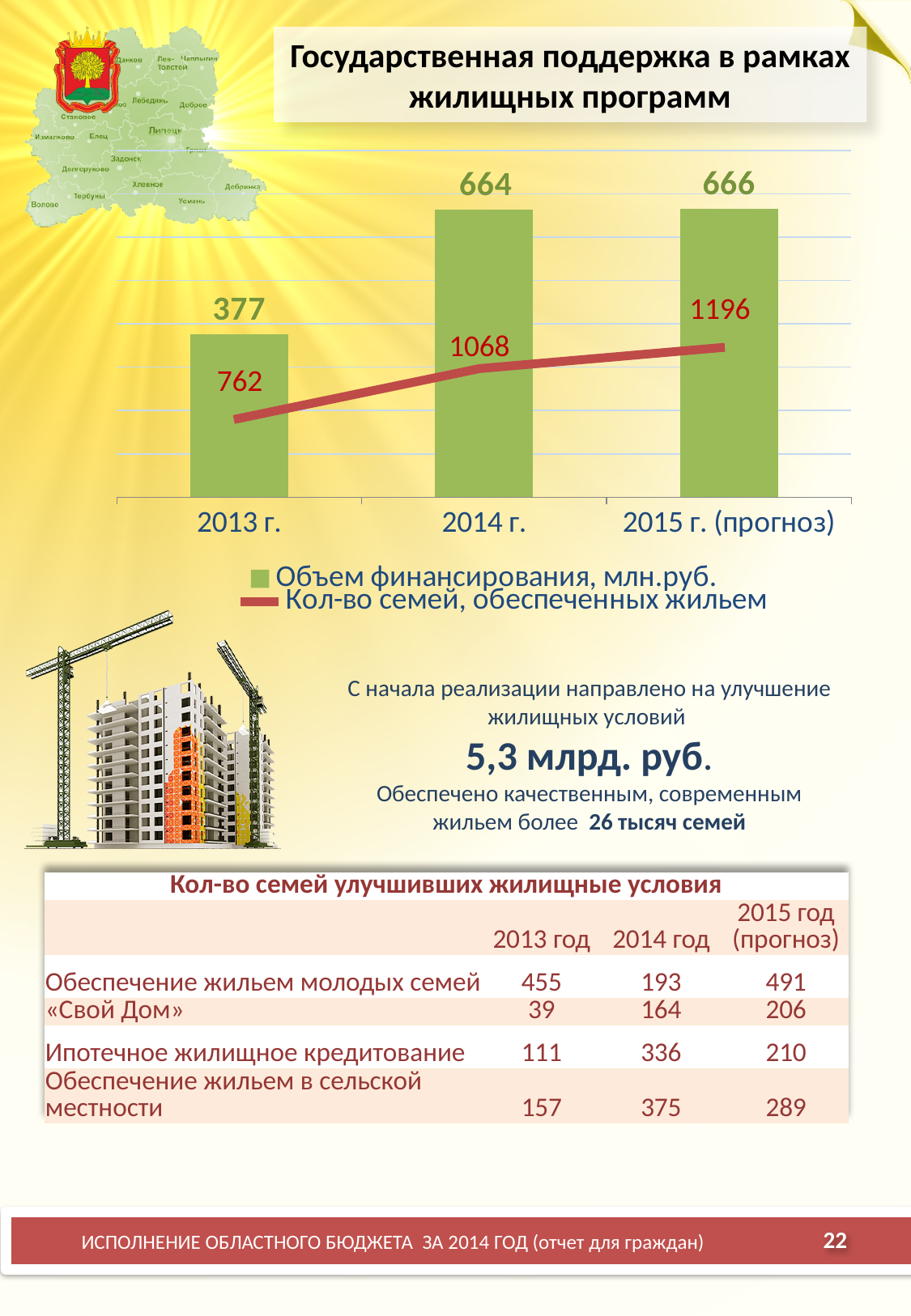
What is the value of Кол-во семей, обеспеченных жильем for 2015 г. (прогноз)? 1196 Which year has the highest value of Кол-во семей, обеспеченных жильем? 2015 г. (прогноз) What is the difference between Объем финансирования, млн.руб. in 2014 г. and 2013 г.? 287 What is the value of Кол-во семей, обеспеченных жильем for 2013 г.? 762 Is Кол-во семей, обеспеченных жильем larger in 2014 г. or in 2013 г.? 2014 г. What is the value of Объем финансирования, млн.руб. for 2014 г.? 664 What is the value of Объем финансирования, млн.руб. for 2013 г.? 377 Does Кол-во семей, обеспеченных жильем rise or fall from 2013 г. to 2015 г. (прогноз)? rise What is the difference between Кол-во семей, обеспеченных жильем in 2015 г. (прогноз) and 2014 г.? 128 Which year has the lowest value of Объем финансирования, млн.руб.? 2013 г. How many series does the chart legend list? 2 How many categories are shown on the x axis of the chart? 3